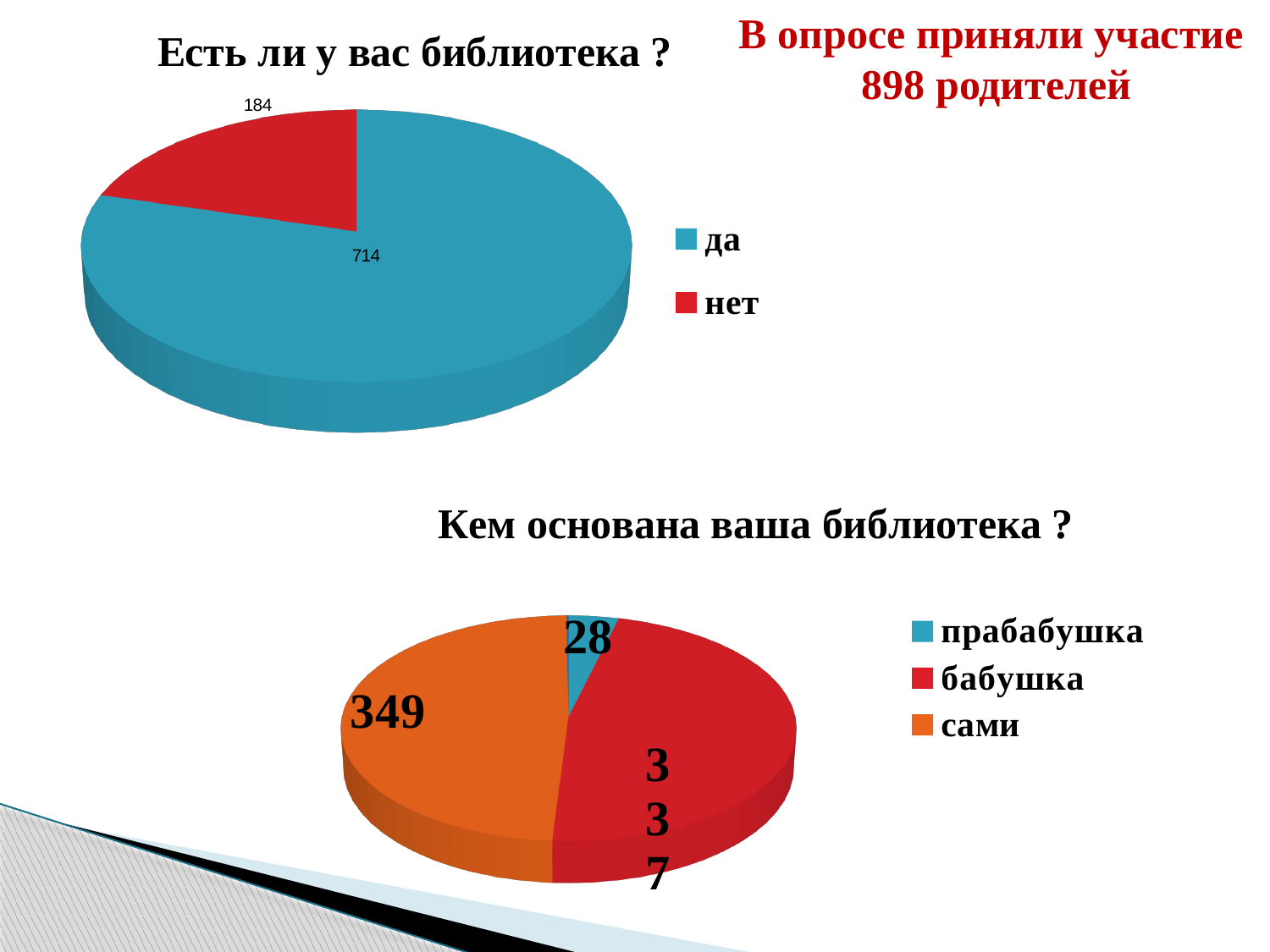
How many categories does the legend of the chart titled "Кем основана ваша библиотека ?" list? 3 In the chart titled "Кем основана ваша библиотека ?", what is the value for "сами"? 349 What kind of chart is the one titled "Есть ли у вас библиотека ?"? pie chart In the chart titled "Кем основана ваша библиотека ?", what colour is the slice for "сами"? orange In the chart titled "Кем основана ваша библиотека ?", which category has the smallest value? прабабушка In the chart titled "Есть ли у вас библиотека ?", what is the value for "нет"? 184 In the chart titled "Кем основана ваша библиотека ?", what is the value for "прабабушка"? 28 In the chart titled "Есть ли у вас библиотека ?", what is the difference between the values for "да" and "нет"? 530 In the chart titled "Есть ли у вас библиотека ?", which category has the larger value? да In the chart titled "Кем основана ваша библиотека ?", what is the value for "бабушка"? 337 In the chart titled "Есть ли у вас библиотека ?", what is the value for "да"? 714 In the chart titled "Кем основана ваша библиотека ?", which is larger, "бабушка" or "сами"? сами